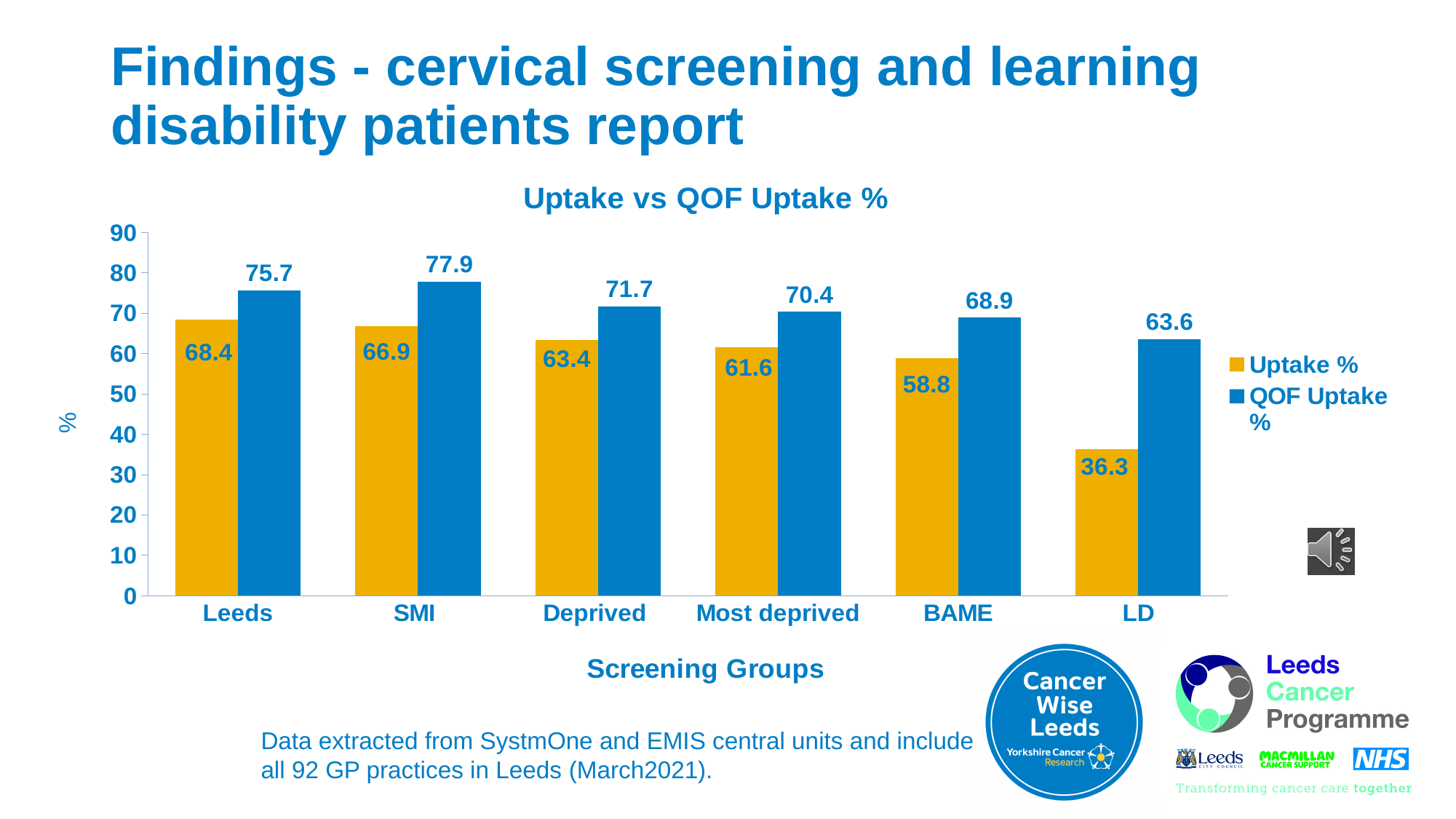
Is the Uptake % value for Deprived greater or less than 60? greater What is the Uptake % value for LD? 36.3 How many screening groups are shown on the x axis? 6 Which is larger for Most deprived: Uptake % or QOF Uptake %? QOF Uptake % How many series does the legend list? 2 Which screening group has the lowest Uptake %? LD Which screening group has the highest QOF Uptake %? SMI What is the title of the chart? Uptake vs QOF Uptake % What is the QOF Uptake % value for SMI? 77.9 What kind of chart is shown on the slide? Bar chart What is the difference between the QOF Uptake % and the Uptake % for Leeds? 7.3 What is the Uptake % value for BAME? 58.8